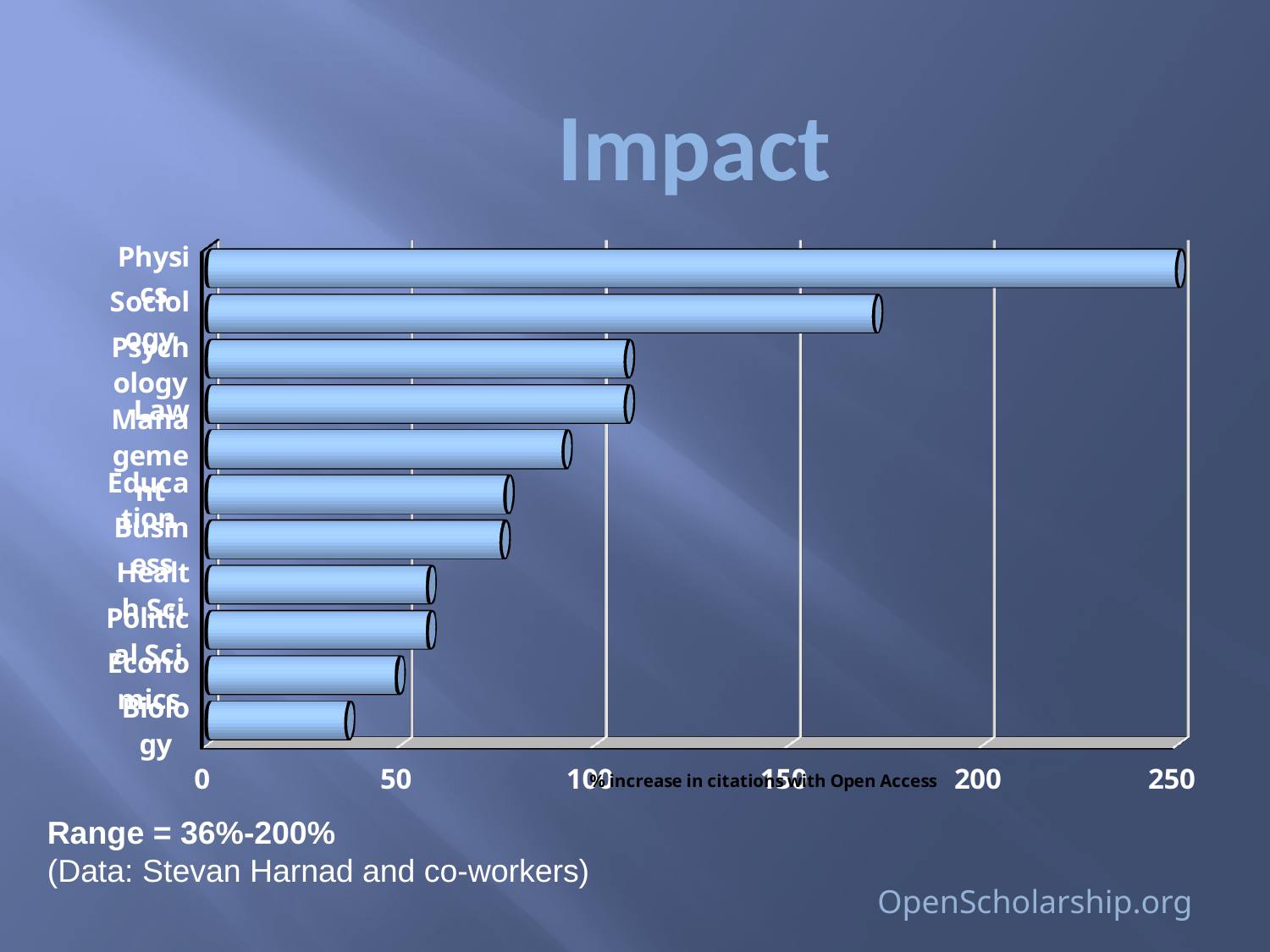
What kind of chart is shown on the slide? bar chart Which has the larger % increase in citations, Sociology or Law? Sociology Is the value for Biology greater or less than 50? less How many categories (disciplines) are plotted in the chart? 11 Is the value for Education greater or less than 50? greater Which discipline has the highest % increase in citations with Open Access? Physics Is the value for Sociology greater or less than 150? greater Which discipline has the lowest % increase in citations with Open Access? Biology What is the title of the horizontal axis of the chart? % increase in citations with Open Access Which has the larger % increase in citations, Management or Education? Management